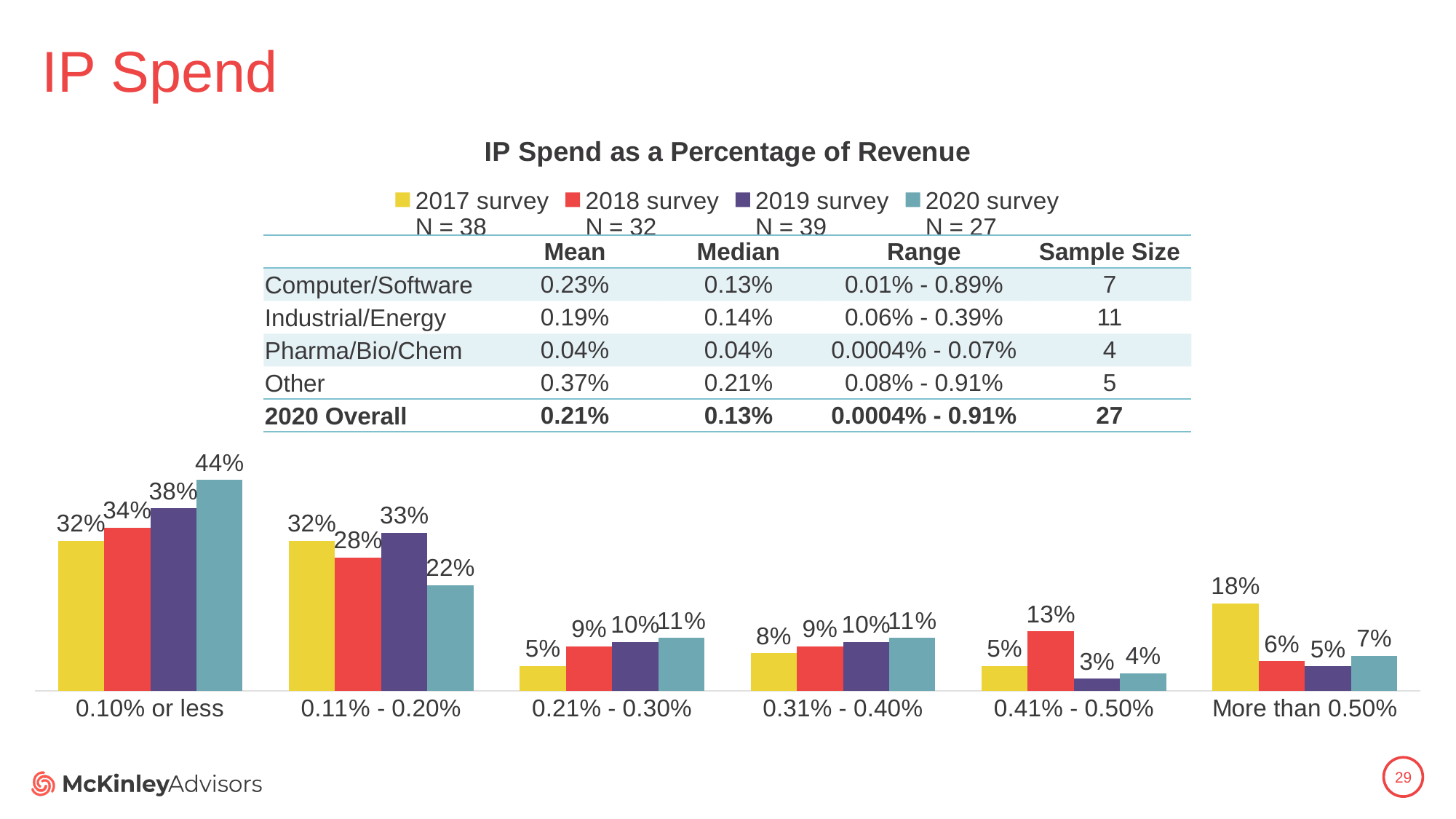
What is the value for the 2018 survey in the "0.41% - 0.50%" category? 13% Which is larger in the "0.11% - 0.20%" category: the 2017 survey value or the 2020 survey value? 2017 survey What is the value for the 2019 survey in the "0.11% - 0.20%" category? 33% How many categories are shown on the x axis? 6 Which category has the lowest value for the 2019 survey? 0.41% - 0.50% What is the value for the 2020 survey in the "0.10% or less" category? 44% Which category has the highest value for the 2020 survey? 0.10% or less What is the value for the 2017 survey in the "More than 0.50%" category? 18% How many series does the legend list? 4 What is the sample size (N) for the 2020 survey shown in the legend? N = 27 What is the difference between the 2020 survey and 2017 survey values in the "0.10% or less" category? 12% What kind of chart is shown on the slide? Bar chart